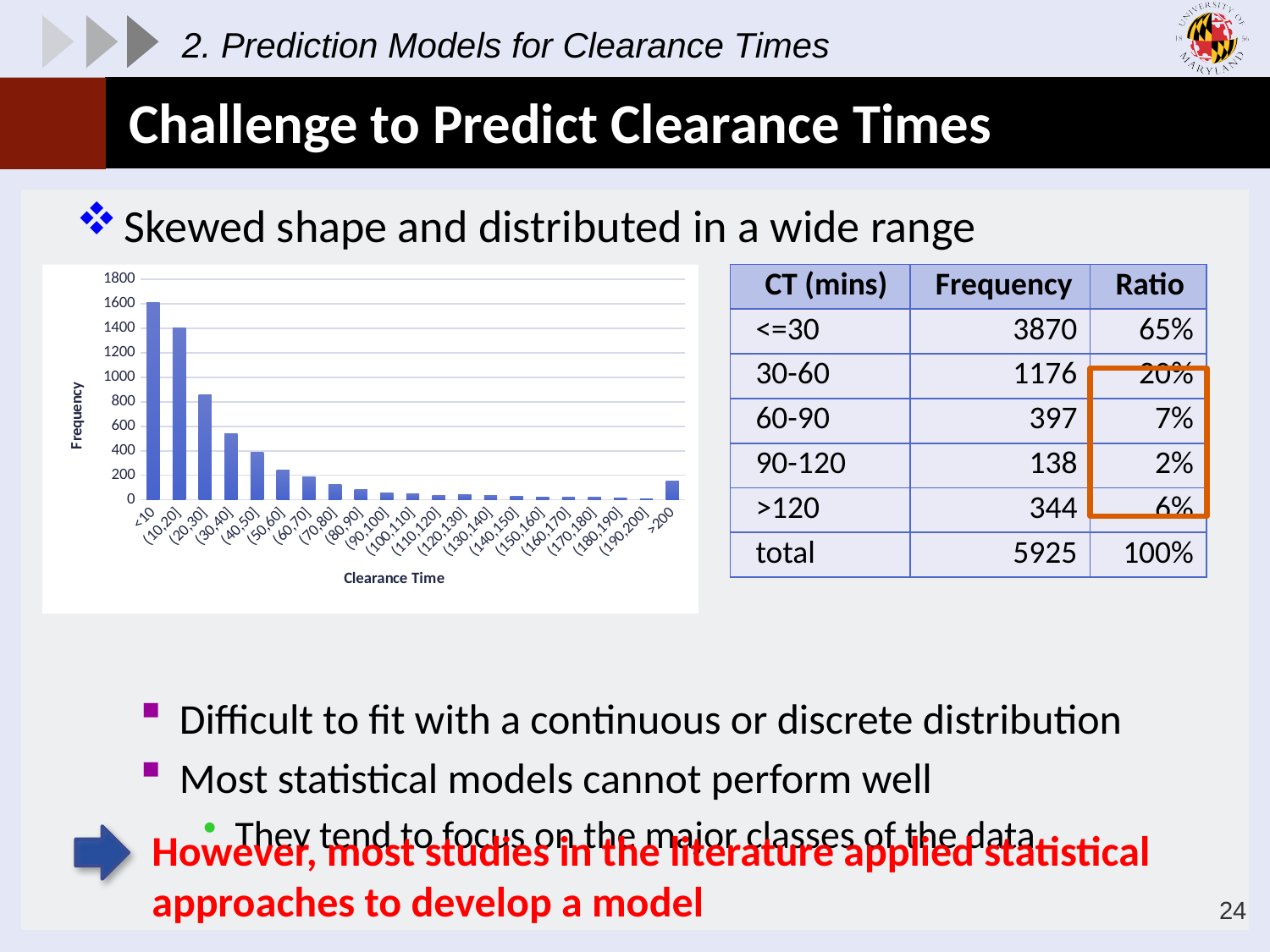
Which clearance time category has the highest frequency in the bar chart? <10 Is the frequency for the (30,40] category greater or less than 400? greater How many clearance time categories are shown on the x axis of the bar chart? 21 Is the frequency for the >200 category greater or less than 200? less Do the frequencies generally rise or fall moving from <10 toward (190,200] along the x axis? fall What is the title of the x axis of the bar chart? Clearance Time Is the frequency for the (20,30] category greater or less than 1000? less Which has a higher frequency, the (190,200] category or the >200 category? >200 What kind of chart is shown on the slide? bar chart Which has a higher frequency, the <10 category or the (10,20] category? <10